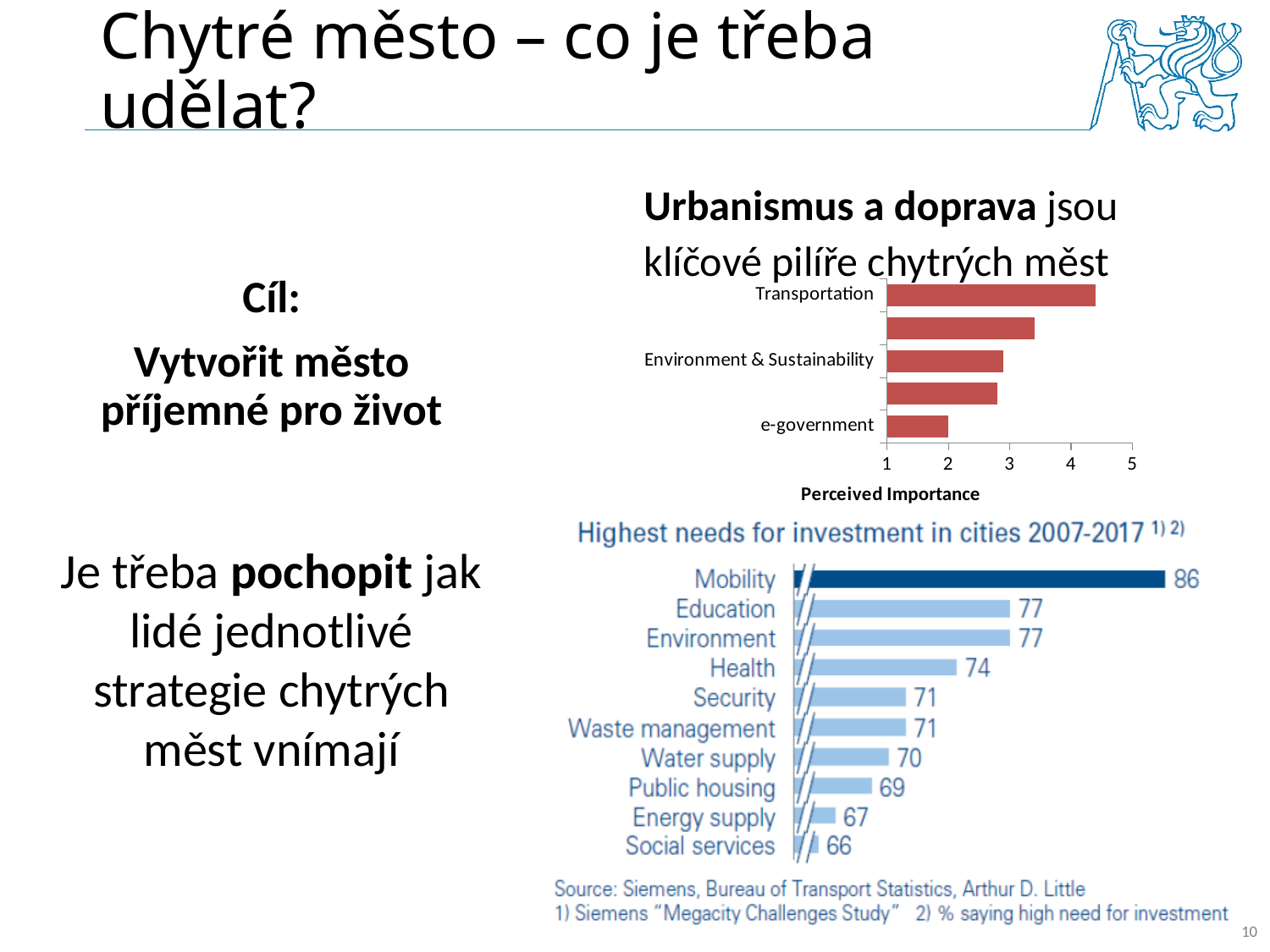
What kind of chart is the 'Highest needs for investment in cities 2007-2017' chart? Bar chart How many categories are shown in the 'Highest needs for investment in cities 2007-2017' chart? 10 In the 'Highest needs for investment in cities 2007-2017' chart, which is larger, the value for Water supply or the value for Energy supply? Water supply In the 'Highest needs for investment in cities 2007-2017' chart, which category has the highest value? Mobility In the 'Perceived Importance' chart at the top right, is the value for Transportation greater or less than 4? greater In the 'Highest needs for investment in cities 2007-2017' chart, what is the value for Health? 74 In the 'Highest needs for investment in cities 2007-2017' chart, which category has the lowest value? Social services In the 'Perceived Importance' chart at the top right, is the value for e-government greater or less than 3? less In the 'Perceived Importance' chart at the top right, which labelled category has the highest value? Transportation In the 'Highest needs for investment in cities 2007-2017' chart, what is the difference between the values for Mobility and Health? 12 In the 'Highest needs for investment in cities 2007-2017' chart, what is the value for Public housing? 69 In the 'Highest needs for investment in cities 2007-2017' chart, what is the value for Mobility? 86